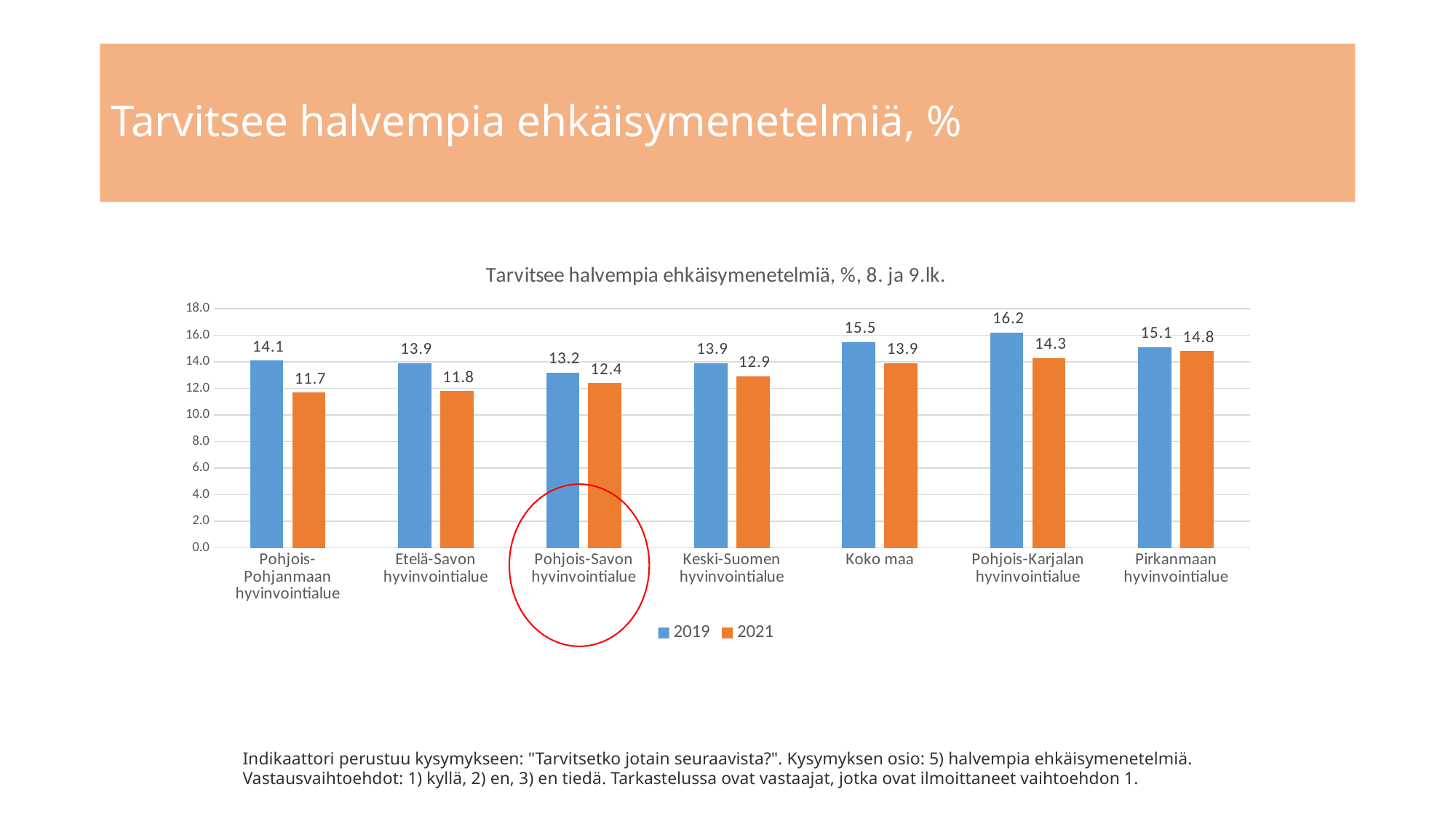
Which is larger for Keski-Suomen hyvinvointialue, the 2019 value or the 2021 value? 2019 What is the difference between the 2019 and 2021 values for Pohjois-Pohjanmaan hyvinvointialue? 2.4 Which category has the highest 2019 value? Pohjois-Karjalan hyvinvointialue Which category has the lowest 2021 value? Pohjois-Pohjanmaan hyvinvointialue Is the 2021 value for Pohjois-Karjalan hyvinvointialue greater or less than 14.0? greater What kind of chart is shown on the slide? bar chart How many categories are shown on the x axis? 7 What is the 2021 value for Pirkanmaan hyvinvointialue? 14.8 How many series does the legend list? 2 Which category is circled in red on the chart? Pohjois-Savon hyvinvointialue What is the 2019 value for Pohjois-Savon hyvinvointialue? 13.2 What is the 2021 value for Koko maa? 13.9